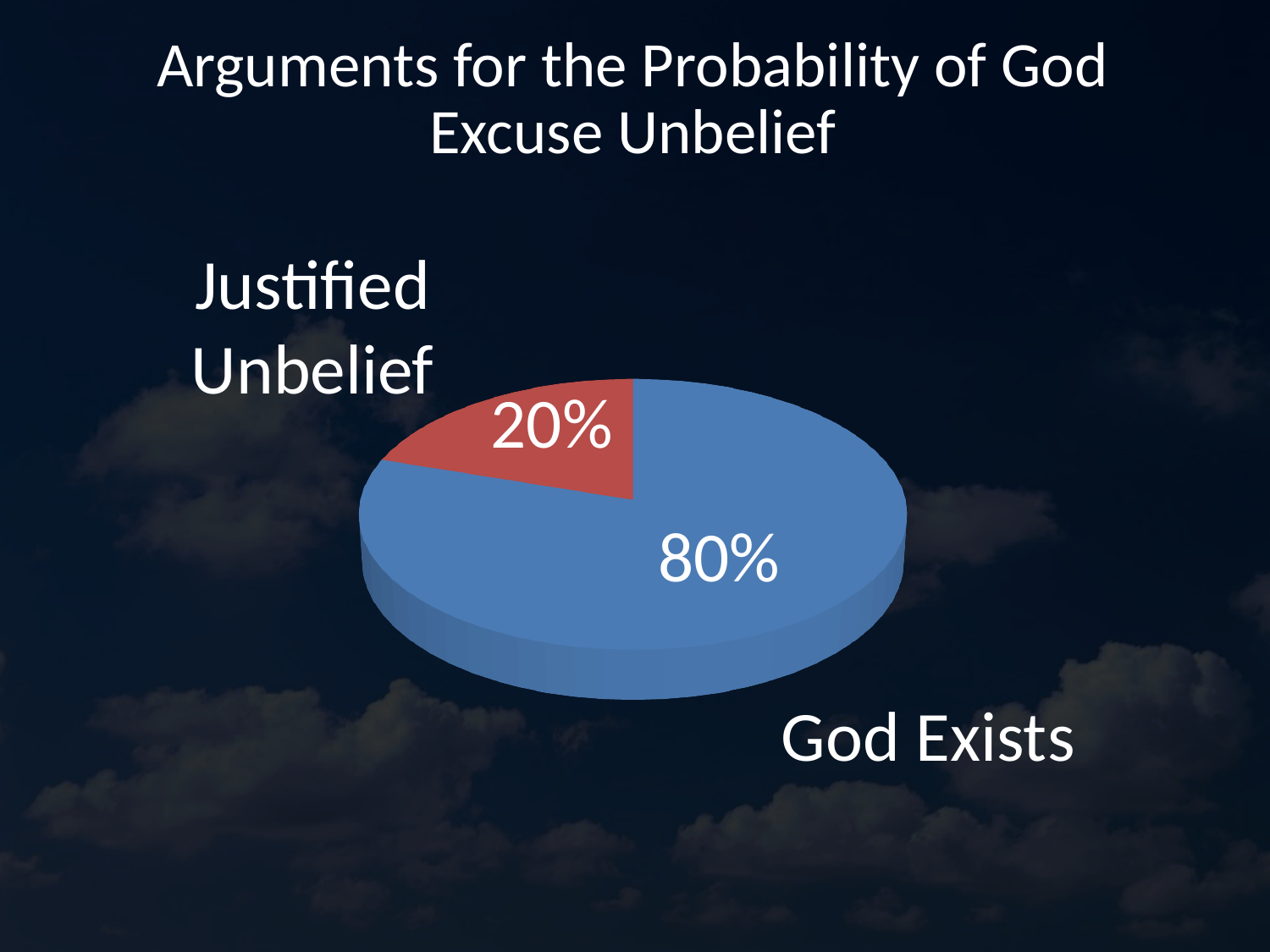
What kind of chart is shown on the slide? pie chart Which is larger, the God Exists slice or the Justified Unbelief slice? God Exists Which slice of the pie is the largest? God Exists How many slices does the pie chart have? 2 Which slice of the pie is the smallest? Justified Unbelief What colour is the God Exists slice? blue What colour is the Justified Unbelief slice? red What share of the pie does the Justified Unbelief slice represent? 20% What is the difference in percentage points between the God Exists slice and the Justified Unbelief slice? 60 What percentage is shown for the God Exists slice? 80% What percentage is shown for the Justified Unbelief slice? 20%